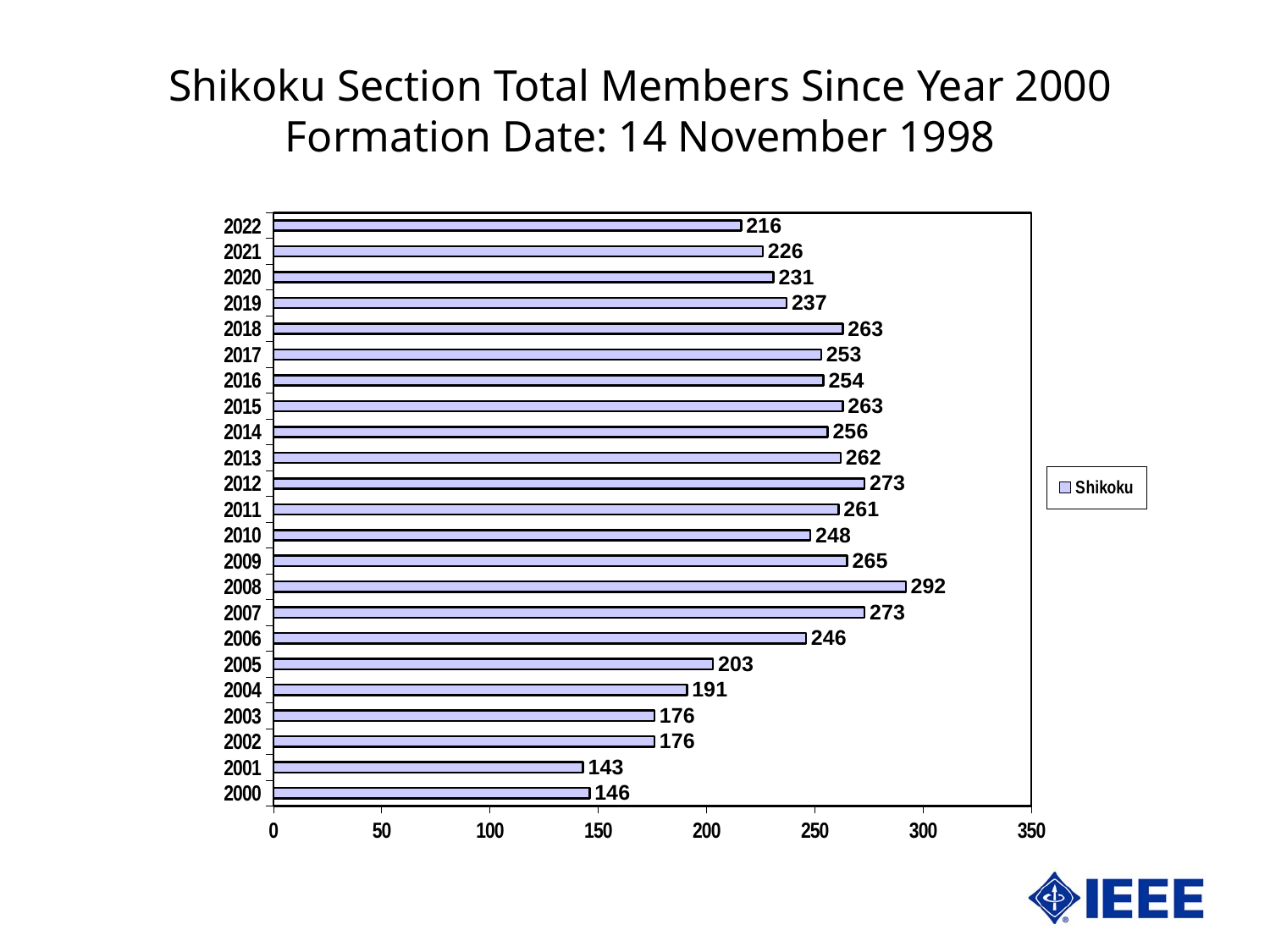
What is the value for 2008? 292 How many years are shown on the chart? 23 Which year has the lowest value? 2001 Which year has the highest value? 2008 What kind of chart is shown? bar chart What is the difference between the values for 2008 and 2022? 76 What is the value for 2000? 146 What is the value for 2022? 216 What series name is shown in the legend? Shikoku Is the value for 2005 greater or less than 200? greater How many series does the legend list? 1 Which is larger, the value for 2012 or the value for 2013? 2012